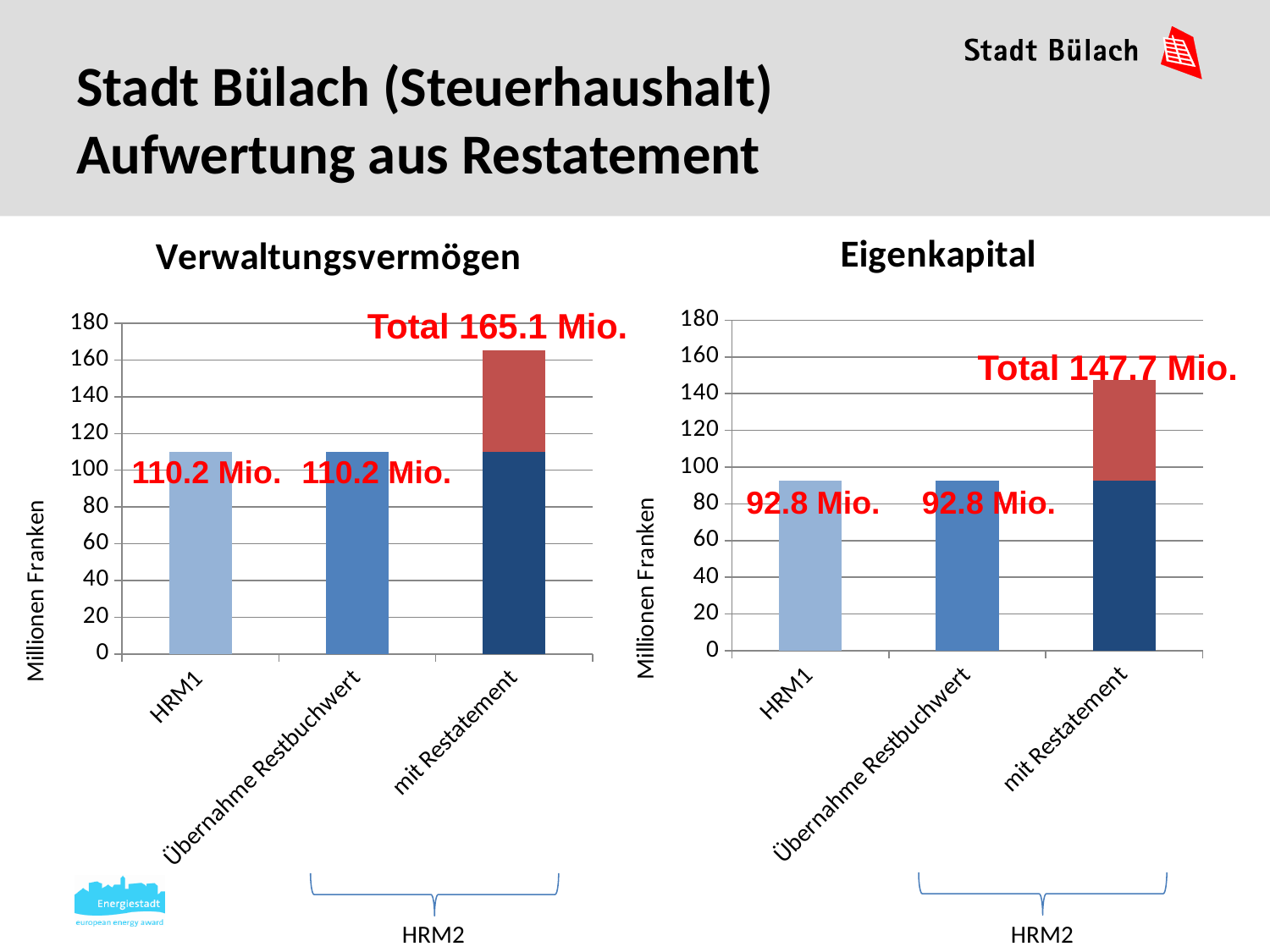
In the Eigenkapital chart, is the value for HRM1 greater or less than 100? less In the Verwaltungsvermögen chart, what is the total for mit Restatement? 165.1 Mio. In the Eigenkapital chart, by how much does the mit Restatement total exceed the HRM1 value? 54.9 Mio. In the Eigenkapital chart, what is the total for mit Restatement? 147.7 Mio. In the Verwaltungsvermögen chart, which category has the highest value? mit Restatement What kind of chart is the Verwaltungsvermögen chart? bar chart How many categories are shown on the x axis of the Eigenkapital chart? 3 In the Verwaltungsvermögen chart, by how much does the mit Restatement total exceed the Übernahme Restbuchwert value? 54.9 Mio. In the Eigenkapital chart, what is the value for Übernahme Restbuchwert? 92.8 Mio. In the Verwaltungsvermögen chart, is the total for mit Restatement greater or less than 160? greater In the Verwaltungsvermögen chart, what is the value for HRM1? 110.2 Mio. What is the y-axis label of the Eigenkapital chart? Millionen Franken